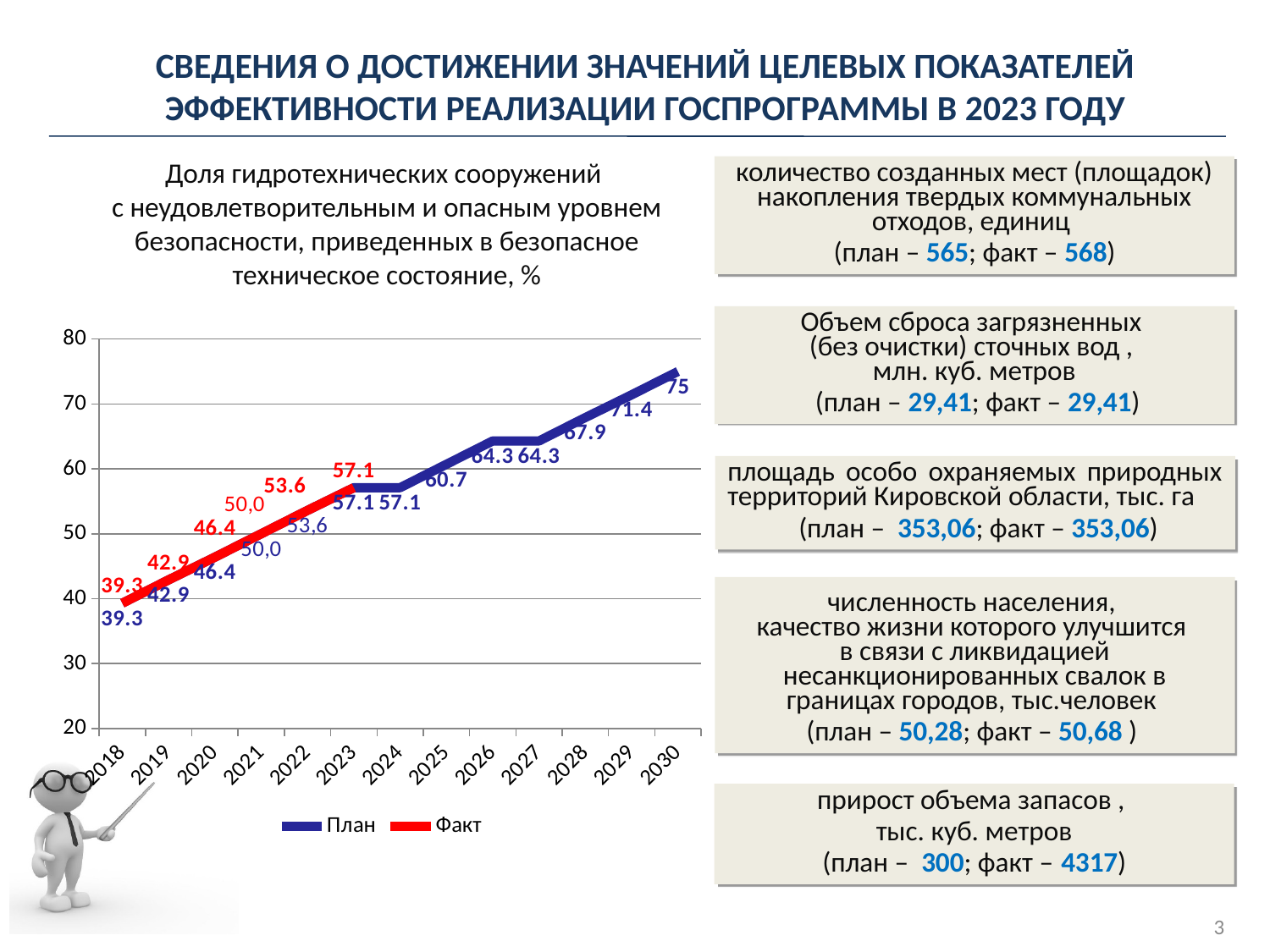
Do the values of the План series rise or fall from 2018 to 2030? rise What is the value of the План series for 2026? 64.3 In which year is the План series at its lowest value? 2018 In which year does the План series reach its highest value? 2030 Which series is drawn in red on the chart? Факт What is the value of the Факт series for 2023? 57.1 What is the difference between the План value for 2030 and the План value for 2018? 35.7 What is the value of the План series for 2029? 71.4 How many years are shown on the x axis of the chart? 13 What kind of chart is shown on the slide? line chart How many series does the chart legend list? 2 Which is larger: the План value for 2025 or the Факт value for 2023? План value for 2025